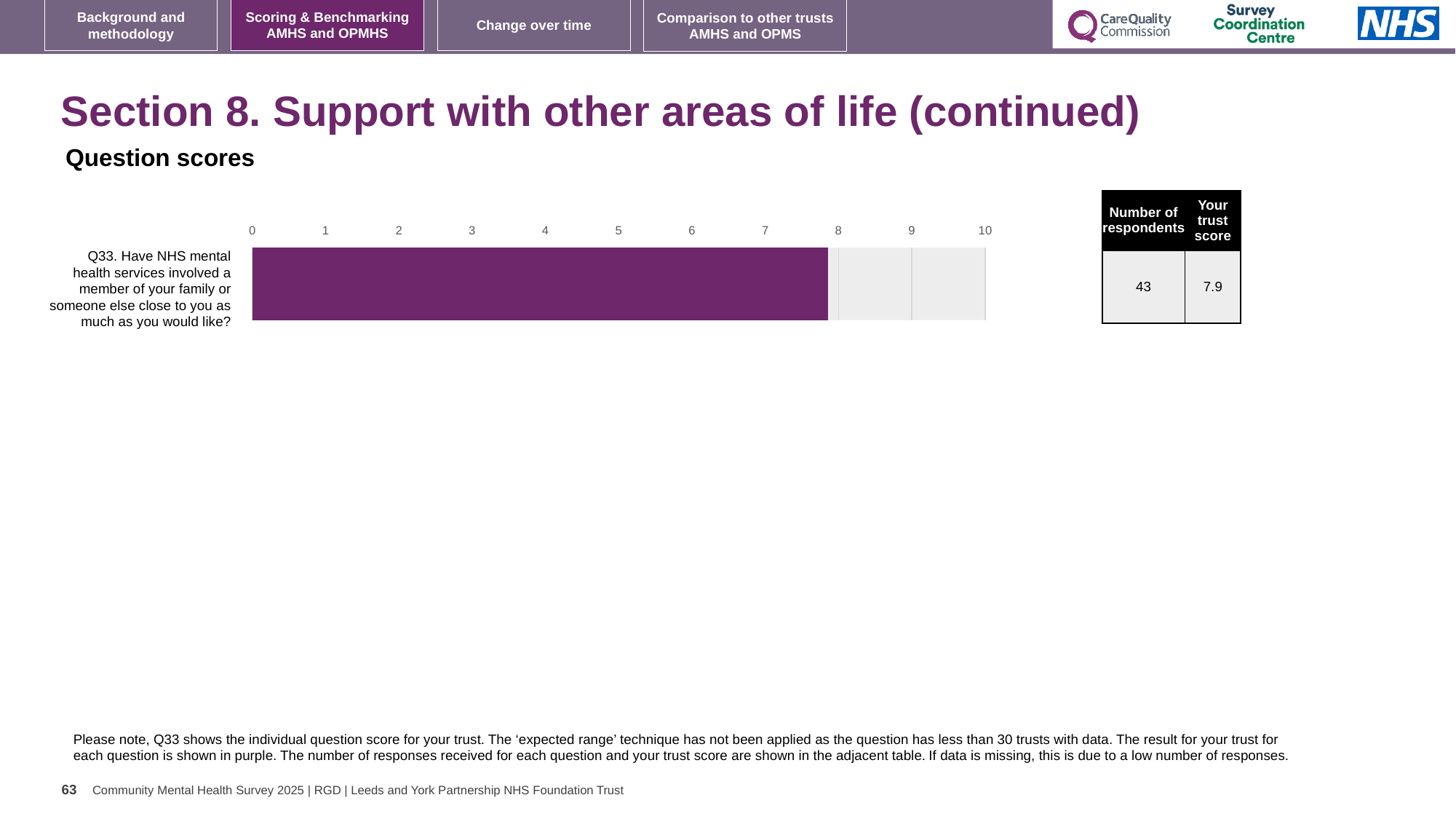
Is the value of the bar for Q33 greater or less than 5? greater What colour is the bar for Q33? Purple How many respondents answered Q33 according to the table? 43 Is the value of the bar for Q33 greater or less than 7? greater What is the maximum value shown on the chart's axis? 10 Which question number is plotted on the chart? Q33 Is the value of the bar for Q33 greater or less than 8? less How many questions (bars) are plotted on the chart? 1 What kind of chart is shown on the slide? Bar chart What is the trust score for Q33 shown in the table next to the chart? 7.9